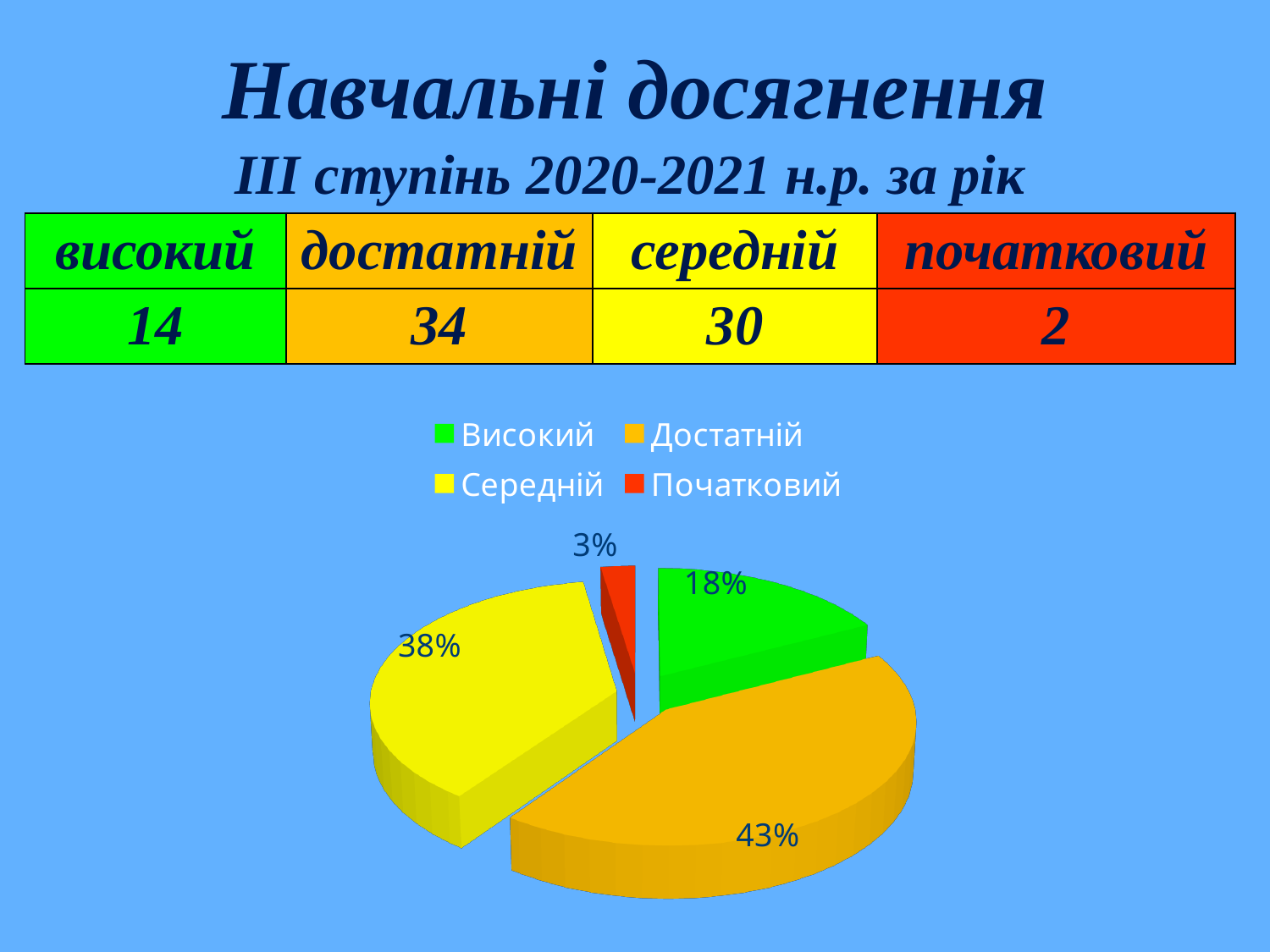
Which category has the largest slice in the pie chart? Достатній Which slice is larger in the pie chart, Високий or Середній? Середній What is the difference in percentage points between the Достатній and Середній slices? 5 What percentage does the Початковий slice show in the pie chart? 3% How many slices does the pie chart have? 4 What percentage does the Високий slice show in the pie chart? 18% How many entries does the legend of the pie chart list? 4 What percentage does the Достатній slice show in the pie chart? 43% What percentage does the Середній slice show in the pie chart? 38% What kind of chart is shown on the slide? pie chart What colour is the Початковий slice in the pie chart? red Which category has the smallest slice in the pie chart? Початковий